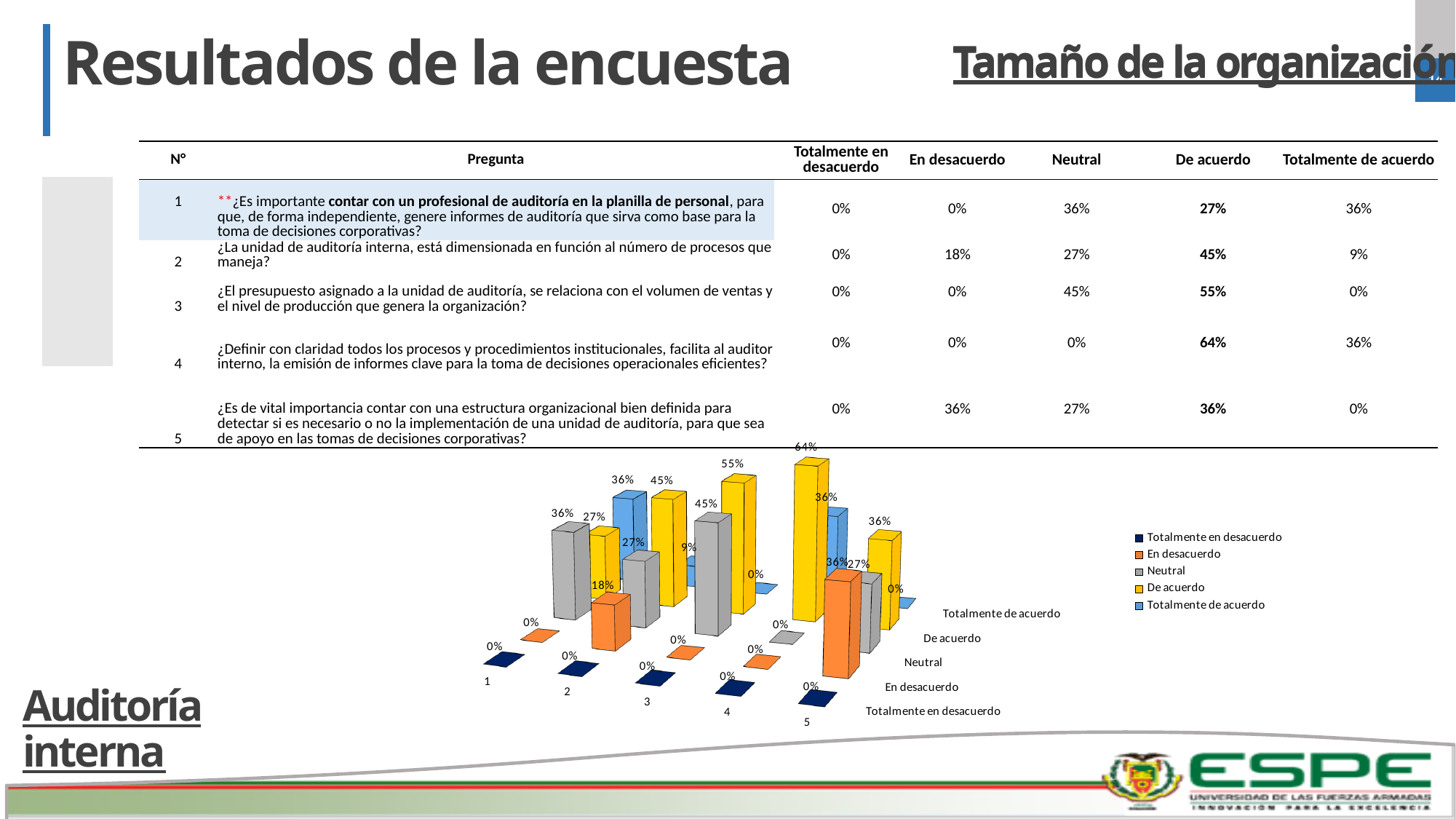
What is the value of 'De acuerdo' for question 4 in the chart? 64% How many series does the chart legend list? 5 What is the value of 'En desacuerdo' for question 2 in the chart? 18% Which question has the highest 'De acuerdo' value in the chart? 4 What is the value of 'Totalmente de acuerdo' for question 2 in the chart? 9% Which question has the lowest 'Neutral' value in the chart? 4 What kind of chart is shown on the slide? bar chart What is the difference between the 'De acuerdo' values for question 3 and question 1 in the chart? 28% Which series in the chart is shown in orange? En desacuerdo In the chart, which is larger for question 5: 'En desacuerdo' or 'Neutral'? En desacuerdo What is the value of 'Totalmente en desacuerdo' for question 3 in the chart? 0% How many question categories are plotted along the x axis of the chart? 5